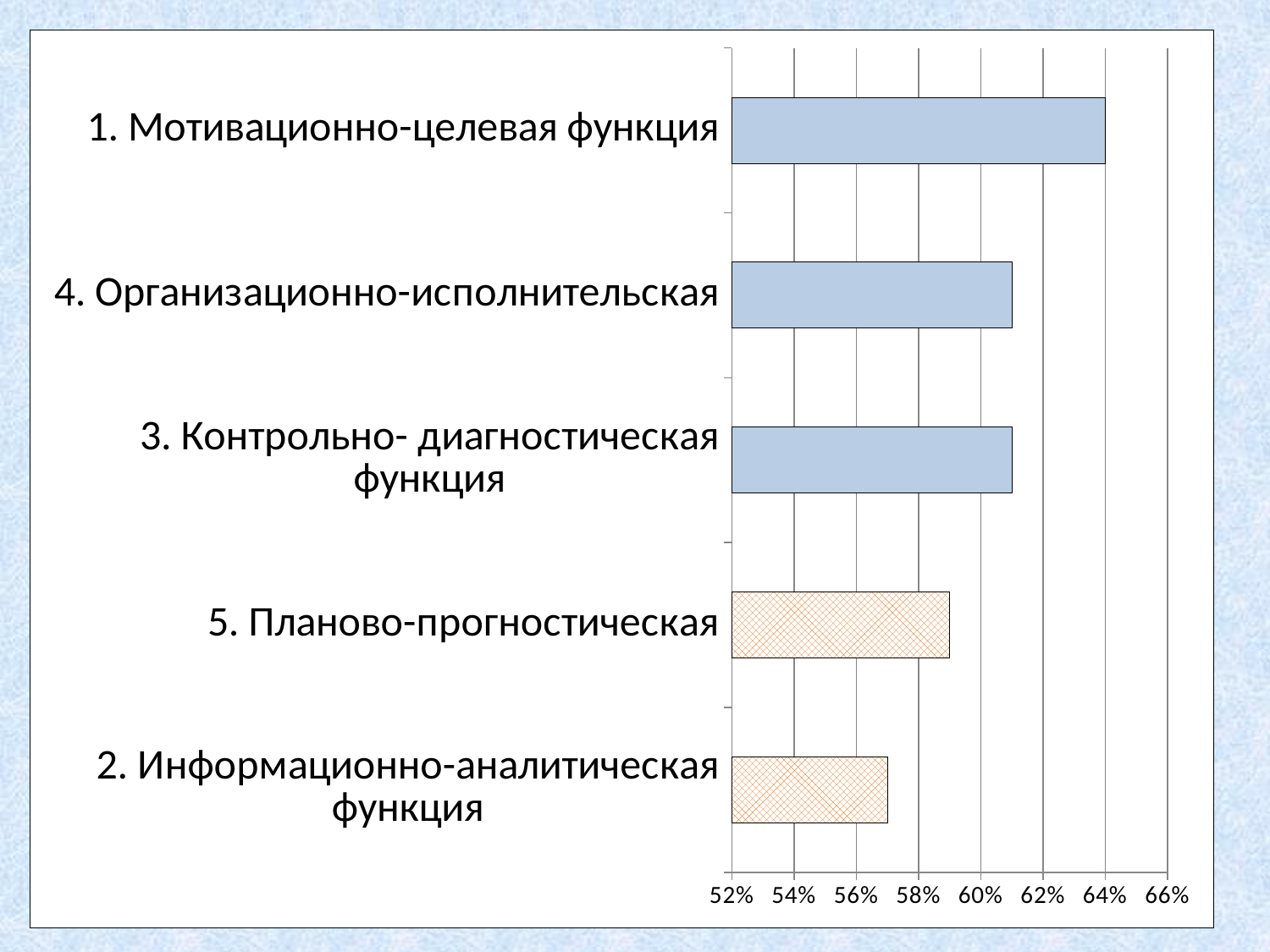
What is the lowest value shown on the horizontal axis? 52% Which is larger: the value for 5. Планово-прогностическая or the value for 2. Информационно-аналитическая функция? 5. Планово-прогностическая Is the value for 5. Планово-прогностическая greater or less than 58%? greater Which is larger: the value for 1. Мотивационно-целевая функция or the value for 4. Организационно-исполнительская? 1. Мотивационно-целевая функция Which category has the highest value? 1. Мотивационно-целевая функция Is the value for 4. Организационно-исполнительская greater or less than 60%? greater What kind of chart is shown on the slide? bar chart How many categories are plotted in the chart? 5 Which category has the lowest value? 2. Информационно-аналитическая функция What is the value for 1. Мотивационно-целевая функция? 64% Is the value for 2. Информационно-аналитическая функция greater or less than 58%? less